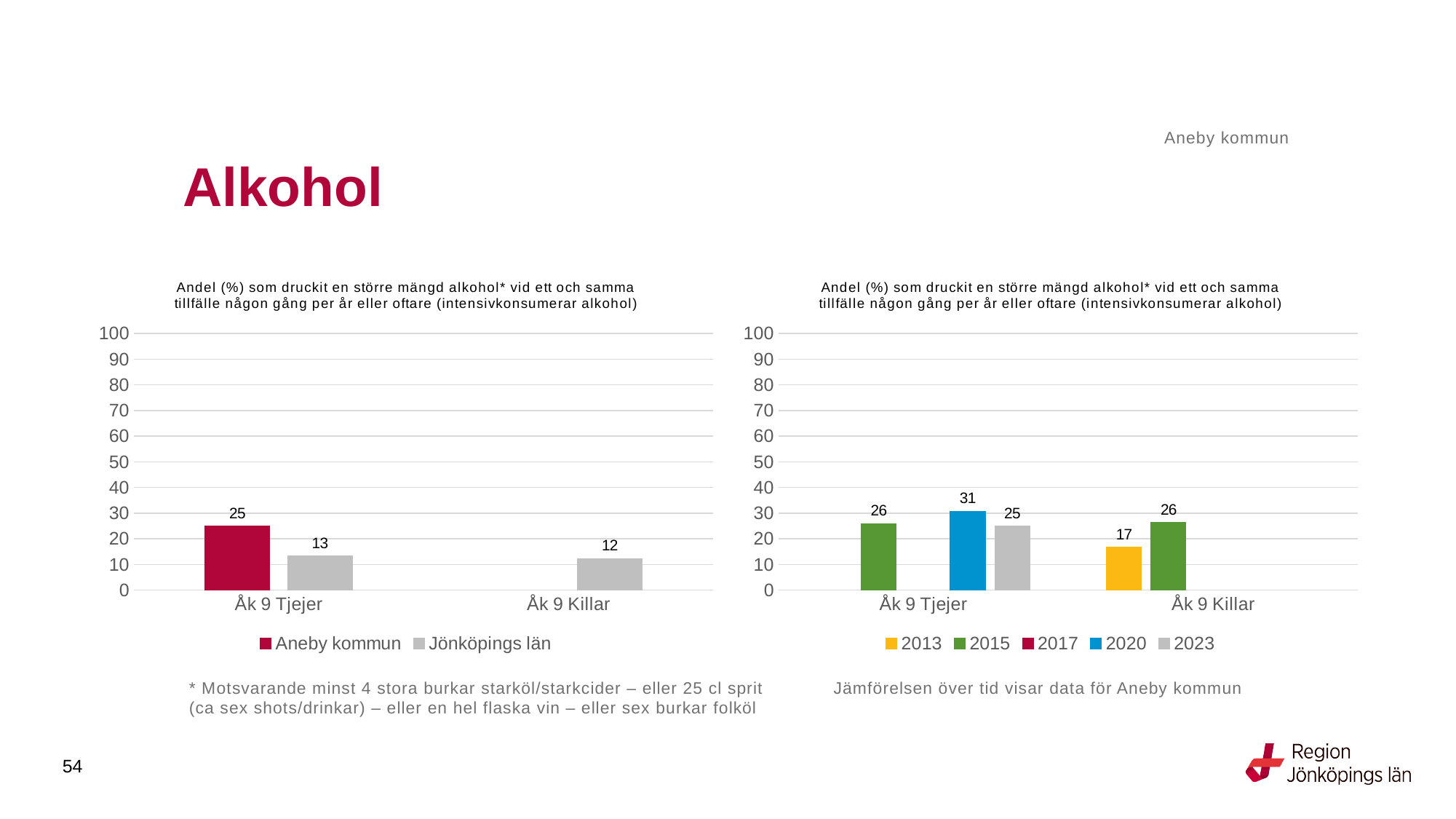
In the left chart, what is the value for Aneby kommun for Åk 9 Tjejer? 25 What type of chart is the right chart? Bar chart In the right chart, what is the value for 2020 for Åk 9 Tjejer? 31 In the right chart, how many series does the legend list? 5 In the left chart, what is the value for Jönköpings län for Åk 9 Killar? 12 In the left chart, which is larger for Åk 9 Tjejer: Aneby kommun or Jönköpings län? Aneby kommun In the left chart, what is the difference between Aneby kommun and Jönköpings län for Åk 9 Tjejer? 12 In the right chart, what is the difference between 2015 and 2013 for Åk 9 Killar? 9 In the right chart, which year has the highest value for Åk 9 Tjejer? 2020 In the right chart, is the value for 2023 for Åk 9 Tjejer greater or less than 30? less In the left chart, how many series does the legend list? 2 In the right chart, what is the value for 2013 for Åk 9 Killar? 17